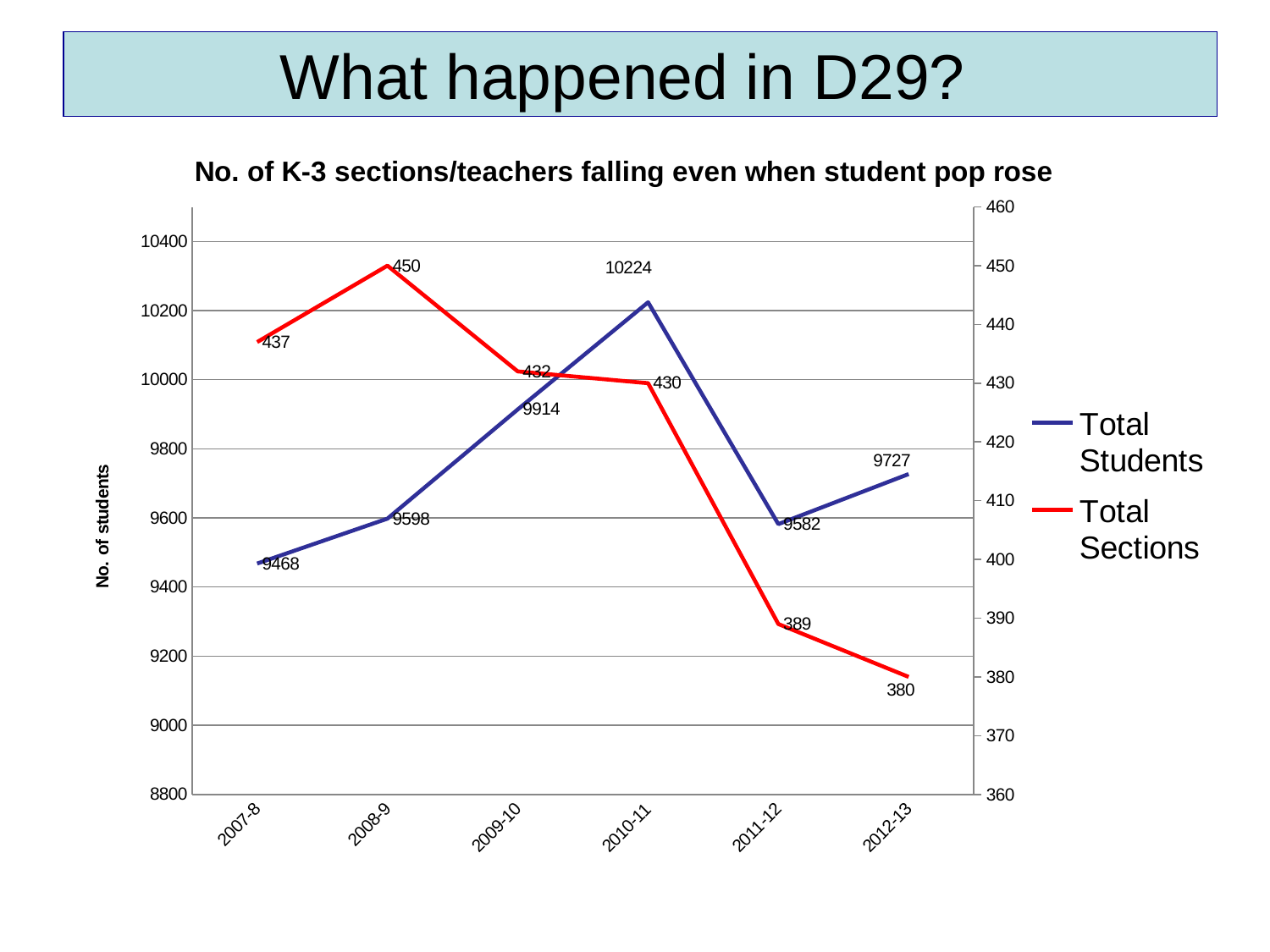
What kind of chart is shown on the slide? line chart How many years are shown on the x axis? 6 What is the difference between Total Sections in 2008-9 and 2012-13? 70 What is the Total Sections value for 2012-13? 380 In which year is Total Sections lowest? 2012-13 What is the difference between Total Students in 2010-11 and 2011-12? 642 In which year is Total Students highest? 2010-11 How many series does the legend list? 2 What is the Total Students value for 2010-11? 10224 What is the Total Students value for 2007-8? 9468 Which is larger, Total Sections in 2007-8 or in 2011-12? 2007-8 What is the Total Sections value for 2008-9? 450